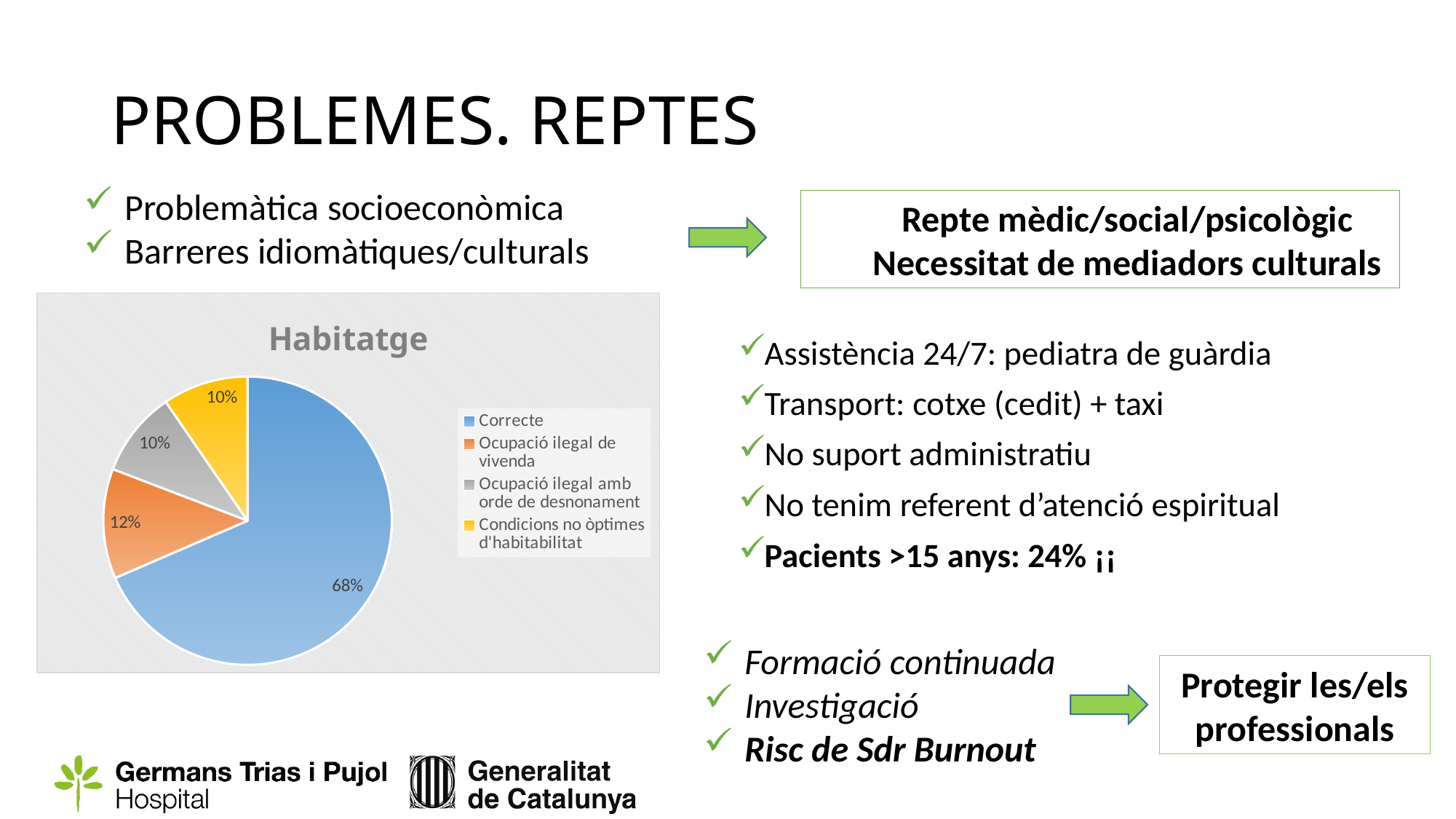
What share of the pie does the 'Correcte' slice represent? 68% What share of the pie does 'Ocupació ilegal de vivenda' represent? 12% How many categories does the legend list? 4 Which is larger, the share for 'Ocupació ilegal de vivenda' or the share for 'Condicions no òptimes d'habitabilitat'? Ocupació ilegal de vivenda What share of the pie does 'Ocupació ilegal amb orde de desnonament' represent? 10% What kind of chart is shown on the slide? pie chart What is the combined share of the three non-'Correcte' categories? 32% Which category has the largest slice of the pie? Correcte What colour is the 'Correcte' slice? blue What is the difference between the 'Correcte' share and the 'Ocupació ilegal de vivenda' share? 56% What is the title of the chart? Habitatge